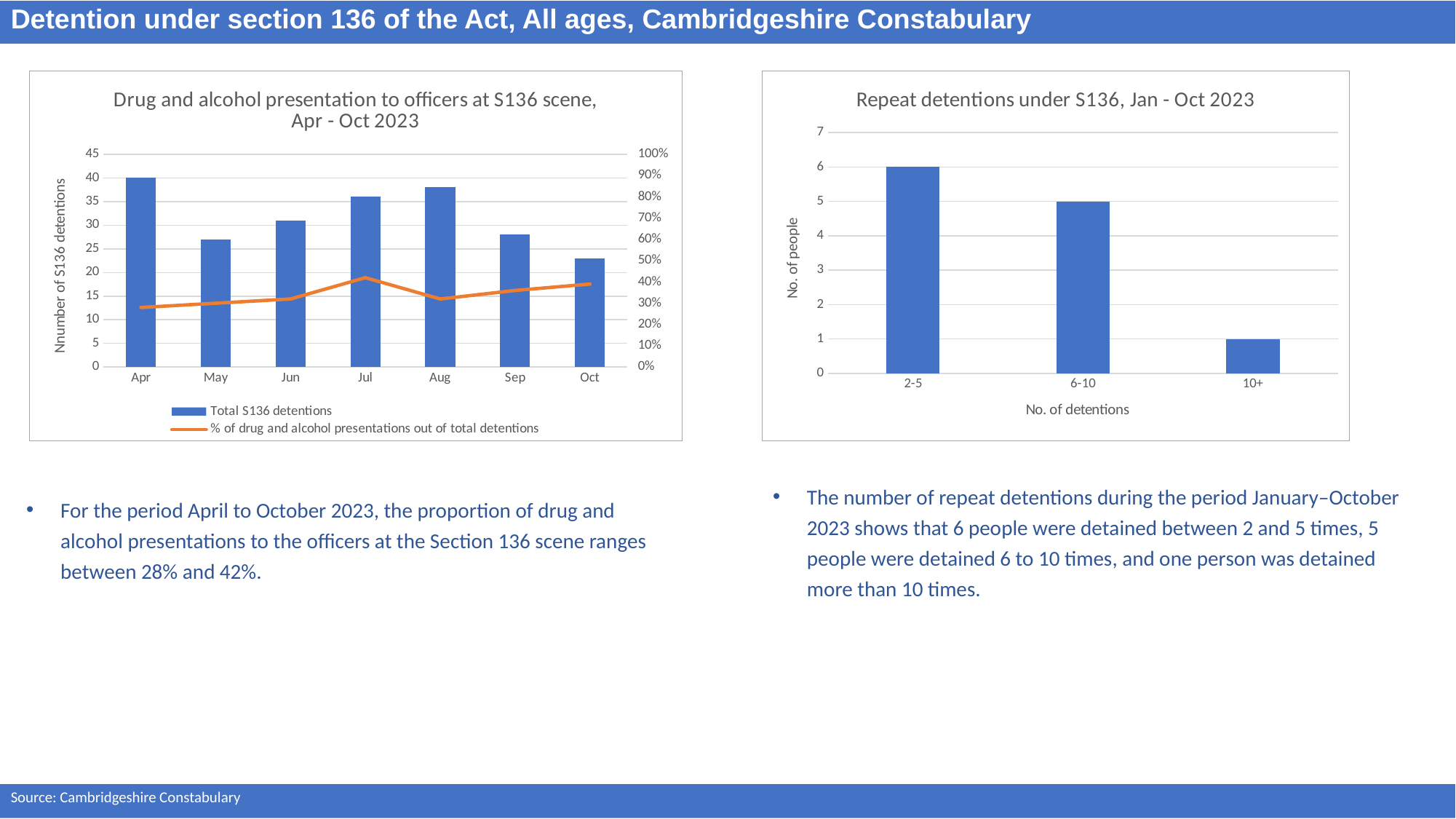
In the chart 'Repeat detentions under S136, Jan - Oct 2023', which category has the highest number of people? 2-5 In the chart 'Drug and alcohol presentation to officers at S136 scene, Apr - Oct 2023', which month has more total S136 detentions, Aug or Sep? Aug In the chart 'Repeat detentions under S136, Jan - Oct 2023', how many categories are shown on the x axis? 3 In the chart 'Drug and alcohol presentation to officers at S136 scene, Apr - Oct 2023', what is the total number of S136 detentions in Apr? 40 What type of chart is 'Repeat detentions under S136, Jan - Oct 2023'? Bar chart In the chart 'Drug and alcohol presentation to officers at S136 scene, Apr - Oct 2023', which month has the lowest total S136 detentions? Oct In the chart 'Repeat detentions under S136, Jan - Oct 2023', what is the difference between the 6-10 and 10+ categories? 4 In the chart 'Repeat detentions under S136, Jan - Oct 2023', what is the value for the 10+ category? 1 In the chart 'Drug and alcohol presentation to officers at S136 scene, Apr - Oct 2023', does the percentage line rise or fall from Apr to Jul? Rises In the chart 'Repeat detentions under S136, Jan - Oct 2023', how many people were detained 2-5 times? 6 How many series does the legend of the chart 'Drug and alcohol presentation to officers at S136 scene, Apr - Oct 2023' list? 2 In the chart 'Drug and alcohol presentation to officers at S136 scene, Apr - Oct 2023', is the total S136 detentions for May greater or less than 30? less